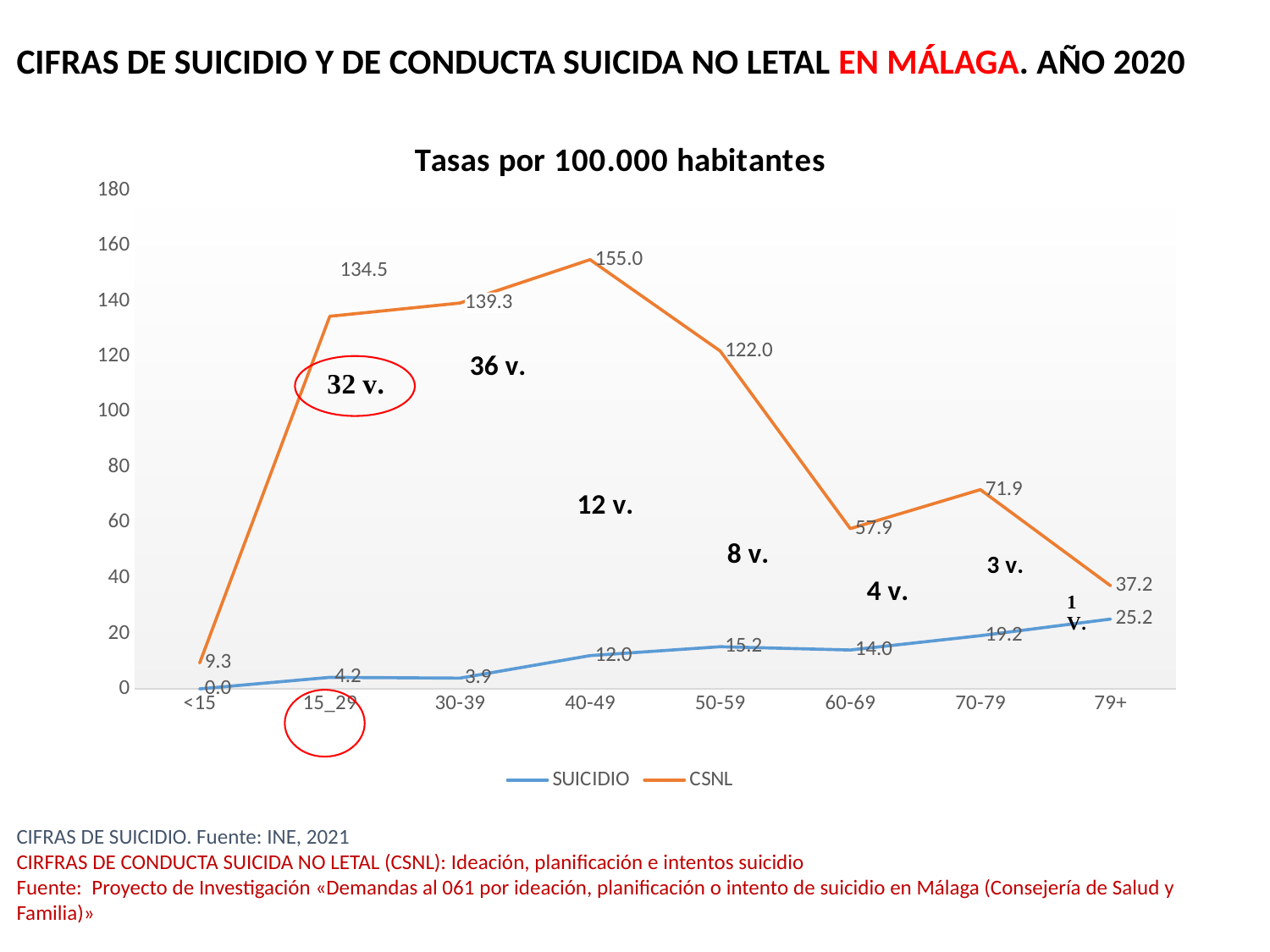
Which age group has the lowest SUICIDIO rate? <15 What is the title of the chart? Tasas por 100.000 habitantes How many series does the legend list? 2 What is the CSNL rate for the 15_29 age group? 134.5 What is the CSNL rate for the 40-49 age group? 155.0 What kind of chart is shown? line chart What is the difference between the CSNL and SUICIDIO rates for the 50-59 age group? 106.8 How many age groups are shown on the x axis? 8 What is the SUICIDIO rate for the 70-79 age group? 19.2 Which is larger, the CSNL rate for 60-69 or the CSNL rate for 70-79? 70-79 Which age group has the highest CSNL rate? 40-49 Is the CSNL rate for the 30-39 age group greater or less than 120? greater